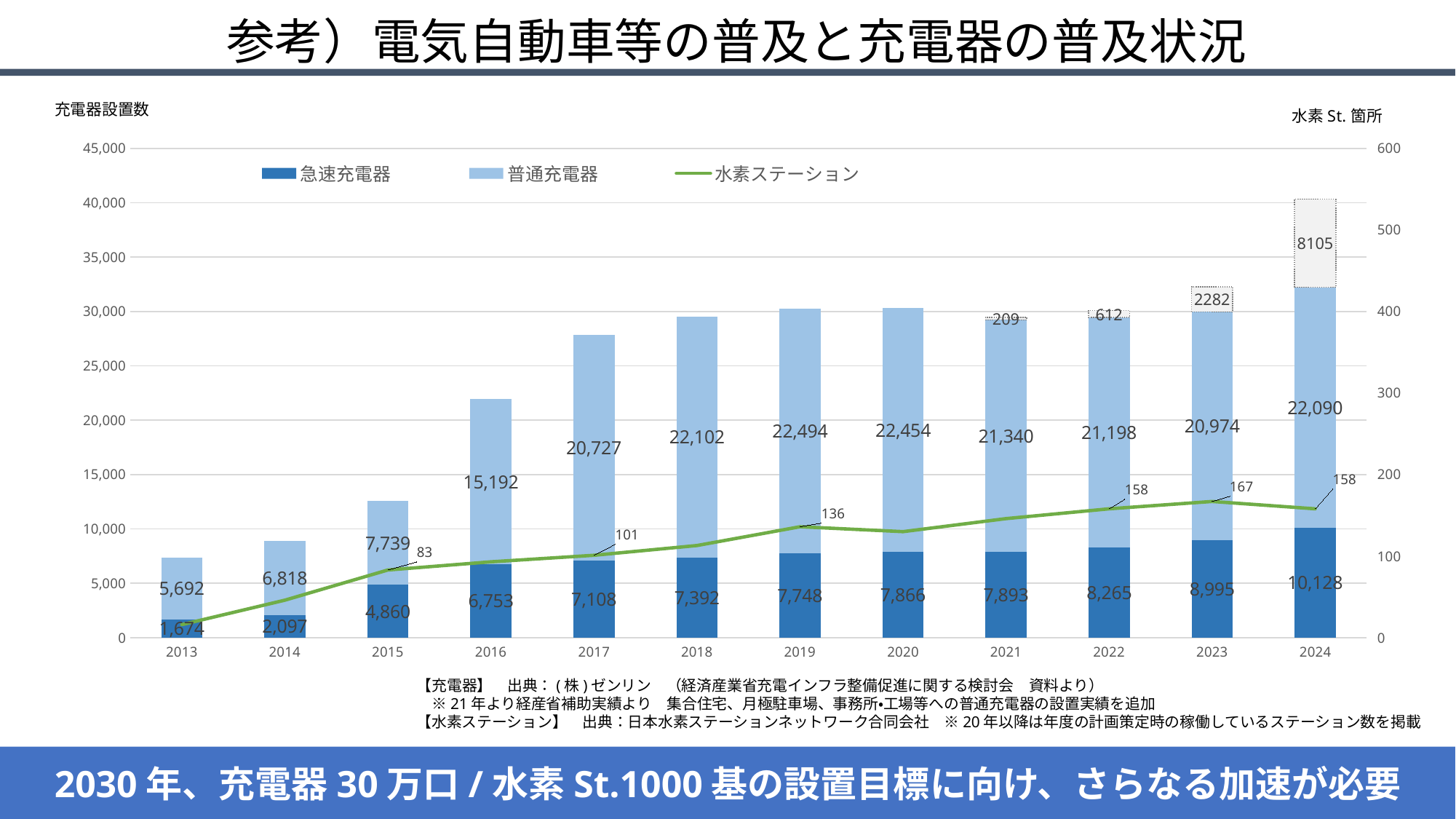
What is the value of 普通充電器 in 2016? 15,192 In which year is 普通充電器 lowest? 2013 Is the total height of the 2016 bar greater or less than 20,000? greater How many series does the legend list? 3 What is the value of 水素ステーション in 2019? 136 How many years are shown on the x axis? 12 What is the value of 急速充電器 in 2024? 10,128 What is the difference between 急速充電器 in 2024 and in 2013? 8,454 What is the total of the 2013 stacked bar (急速充電器 plus 普通充電器)? 7,366 What is the value of 急速充電器 in 2013? 1,674 In which year is 急速充電器 highest? 2024 Which is larger, 普通充電器 in 2017 or in 2018? 2018